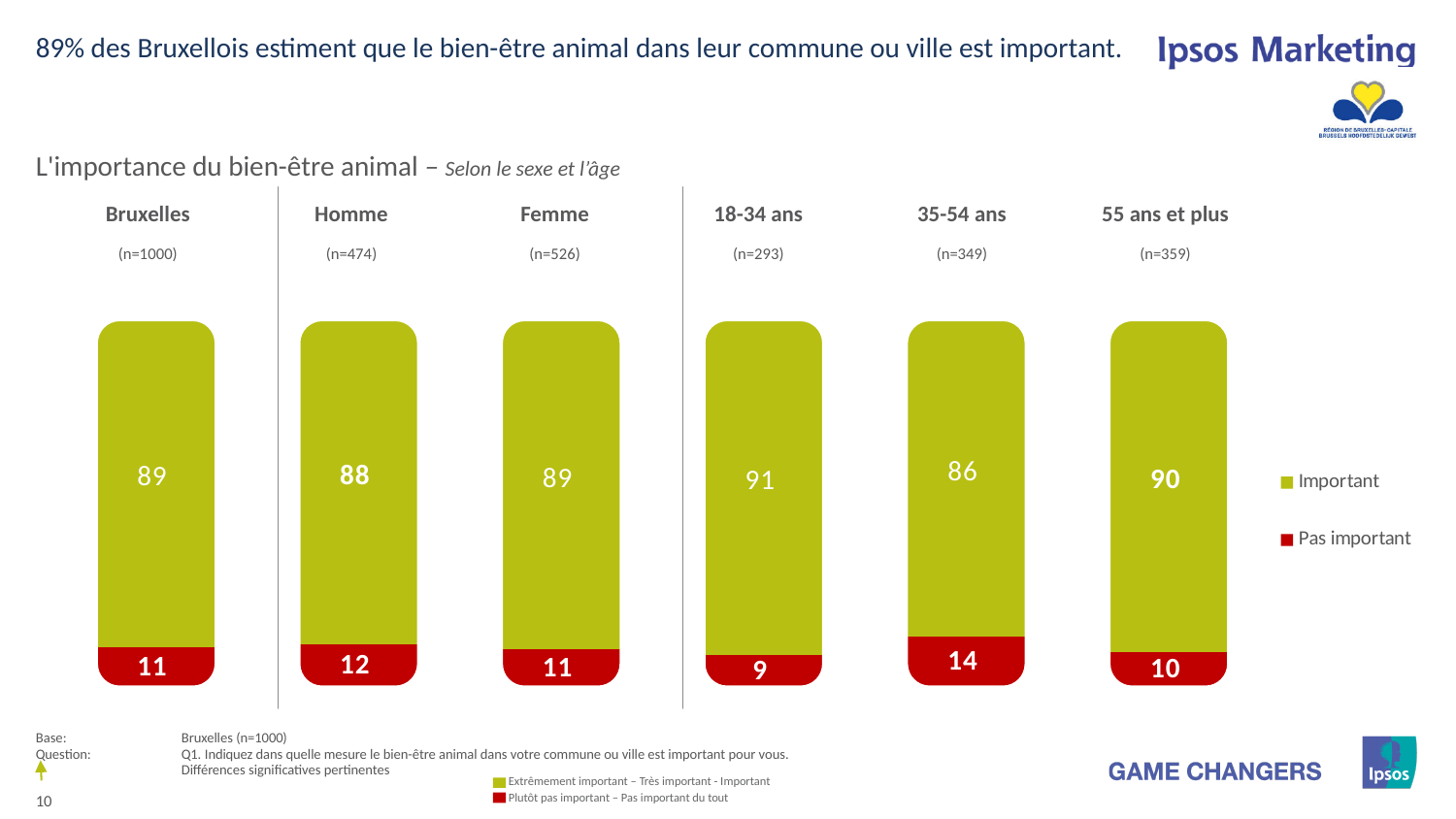
What is the difference between the 'Pas important' values for 35-54 ans and 18-34 ans? 5 Which colour represents 'Pas important' in the chart? Red How many series does the legend list? 2 What is the 'Important' value for the 18-34 ans group? 91 What is the total of the stacked bar for 55 ans et plus? 100 Which group has the lowest 'Important' value? 35-54 ans Which group has the highest 'Important' value? 18-34 ans What kind of chart is shown on the slide? Stacked bar chart Which has a larger 'Important' value, Homme or Femme? Femme What is the 'Pas important' value for the 35-54 ans group? 14 How many groups are shown in the chart? 6 What is the 'Important' value for Homme? 88